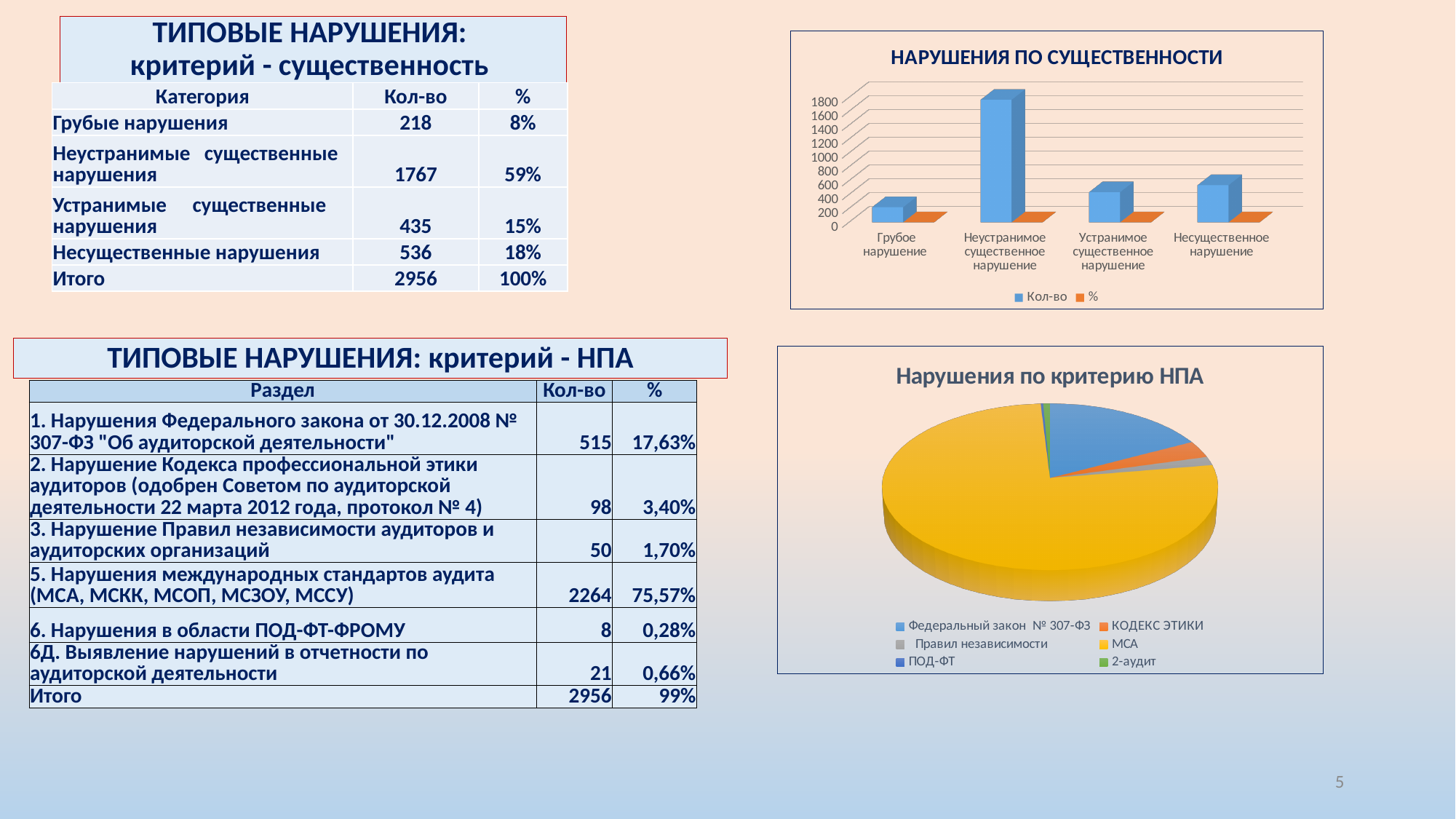
In the chart "НАРУШЕНИЯ ПО СУЩЕСТВЕННОСТИ", which Кол-во bar is taller: Несущественное нарушение or Устранимое существенное нарушение? Несущественное нарушение In the chart "НАРУШЕНИЯ ПО СУЩЕСТВЕННОСТИ", is the Кол-во value for Грубое нарушение greater or less than 400? less In the chart "НАРУШЕНИЯ ПО СУЩЕСТВЕННОСТИ", which category has the lowest Кол-во bar? Грубое нарушение What kind of chart is "НАРУШЕНИЯ ПО СУЩЕСТВЕННОСТИ"? bar chart In the chart "НАРУШЕНИЯ ПО СУЩЕСТВЕННОСТИ", how many series does the legend list? 2 In the chart "НАРУШЕНИЯ ПО СУЩЕСТВЕННОСТИ", is the Кол-во value for Неустранимое существенное нарушение greater or less than 1600? greater What is the title of the bar chart on the slide? НАРУШЕНИЯ ПО СУЩЕСТВЕННОСТИ In the chart "НАРУШЕНИЯ ПО СУЩЕСТВЕННОСТИ", how many categories are shown on the x axis? 4 In the chart "Нарушения по критерию НПА", how many entries does the legend list? 6 What kind of chart is "Нарушения по критерию НПА"? pie chart In the chart "Нарушения по критерию НПА", which legend entry corresponds to the largest slice? МСА In the chart "НАРУШЕНИЯ ПО СУЩЕСТВЕННОСТИ", which category has the highest Кол-во bar? Неустранимое существенное нарушение